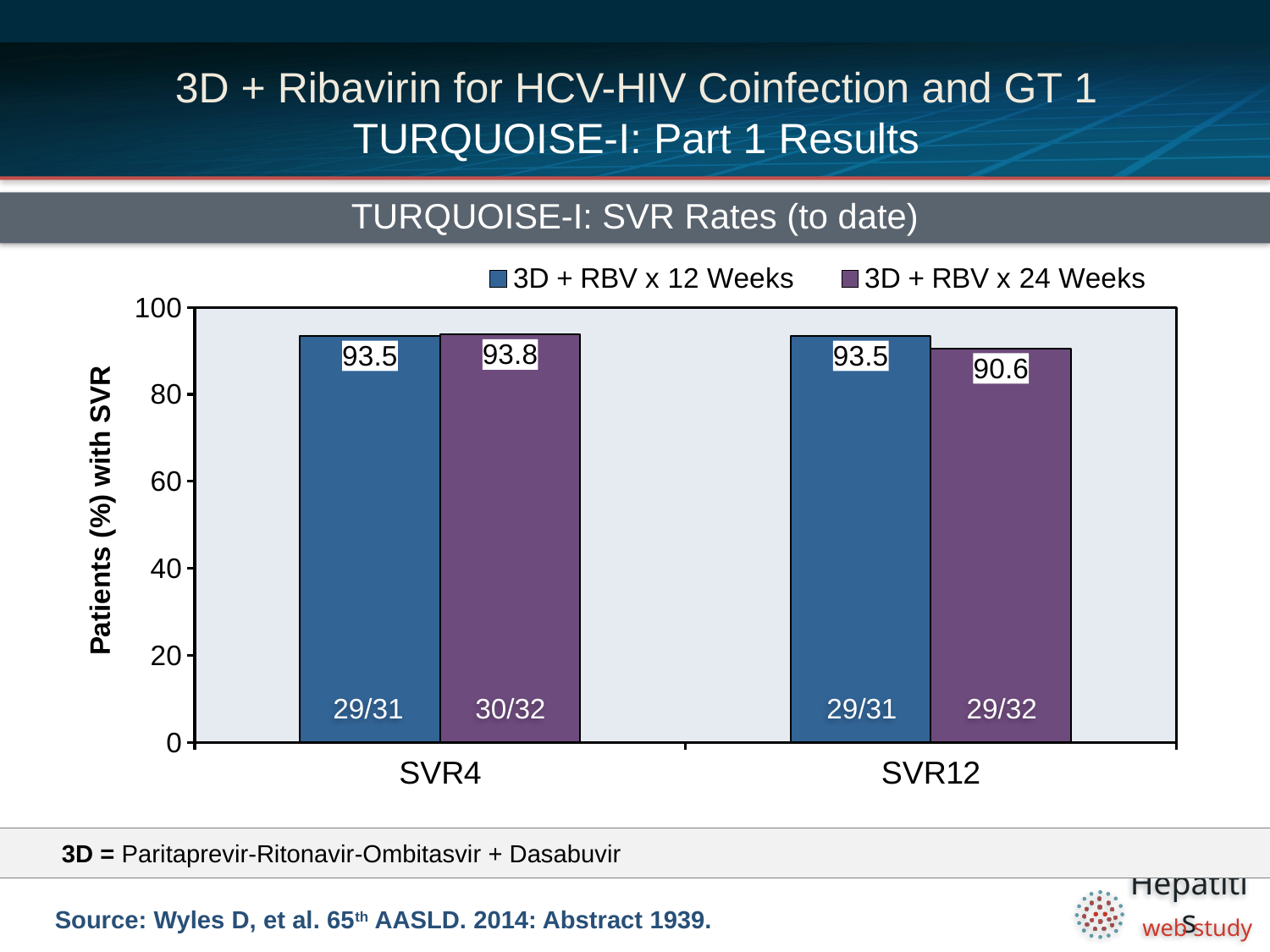
What fraction of patients is shown for the 3D + RBV x 12 Weeks group at SVR4? 29/31 How many categories are shown on the x axis? 2 How many series does the legend list? 2 What is the SVR4 rate for the 3D + RBV x 12 Weeks group? 93.5 Is the SVR12 rate for the 3D + RBV x 24 Weeks group greater or less than 80? greater What is the title of the chart? TURQUOISE-I: SVR Rates (to date) What is the SVR4 rate for the 3D + RBV x 24 Weeks group? 93.8 What fraction of patients is shown for the 3D + RBV x 24 Weeks group at SVR12? 29/32 What kind of chart is shown on the slide? bar chart Which group has the lower SVR12 rate? 3D + RBV x 24 Weeks What is the difference between the SVR4 and SVR12 rates for the 3D + RBV x 24 Weeks group? 3.2 What is the SVR12 rate for the 3D + RBV x 24 Weeks group? 90.6